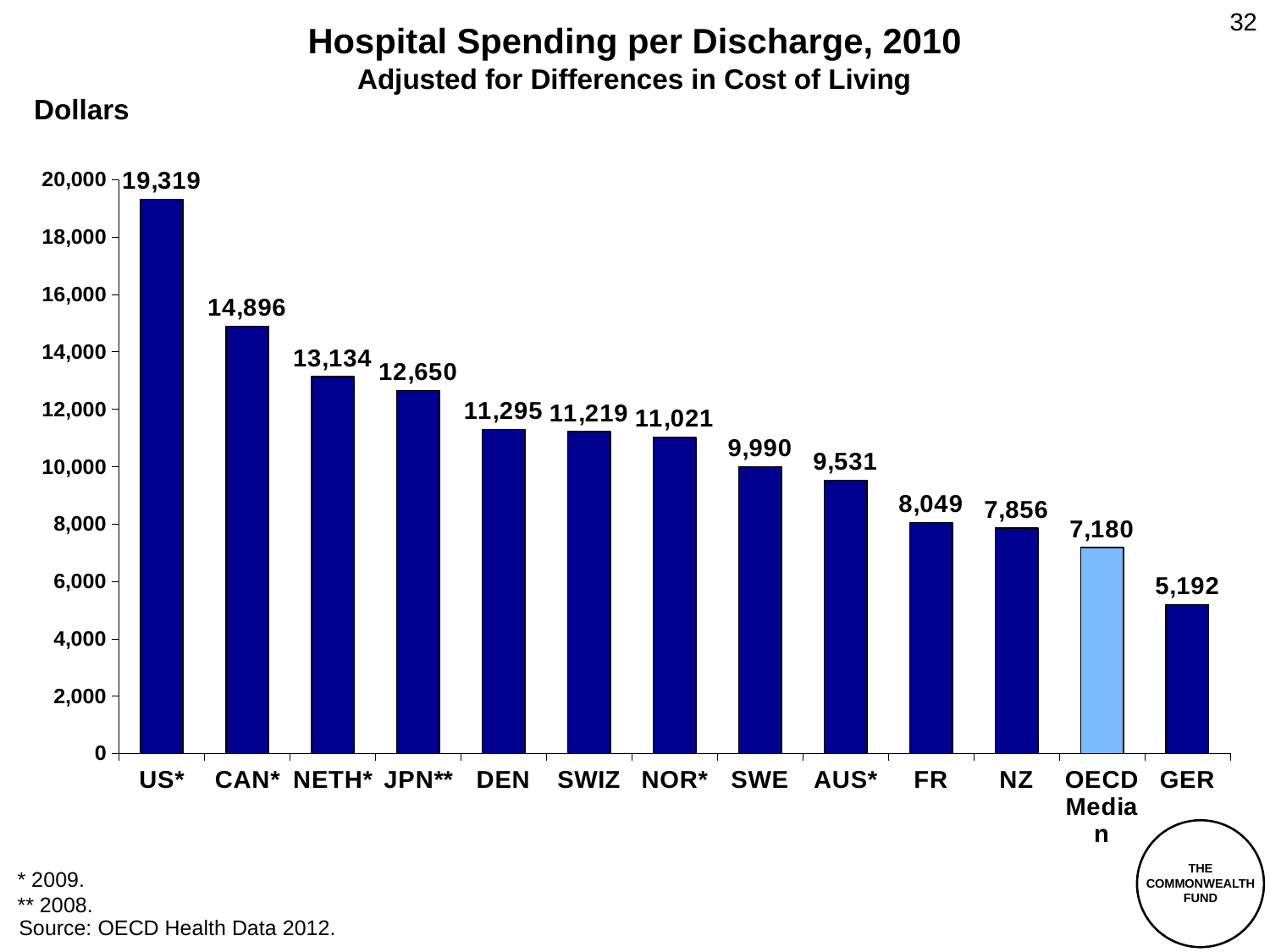
What is the value shown for the OECD Median? 7,180 Which is larger, the value for NETH* or the value for JPN**? NETH* Is the value for AUS* greater or less than 10,000? less What is the difference between the US* and CAN* values? 4,423 Which country has the highest hospital spending per discharge? US* What is the hospital spending per discharge for the US*? 19,319 Which bar is shown in a lighter blue colour than the others? OECD Median What is the difference between the US* and GER values? 14,127 Which country has the lowest hospital spending per discharge? GER How many bars are shown in the chart? 13 What is the hospital spending per discharge for SWE? 9,990 What kind of chart is shown on the slide? Bar chart